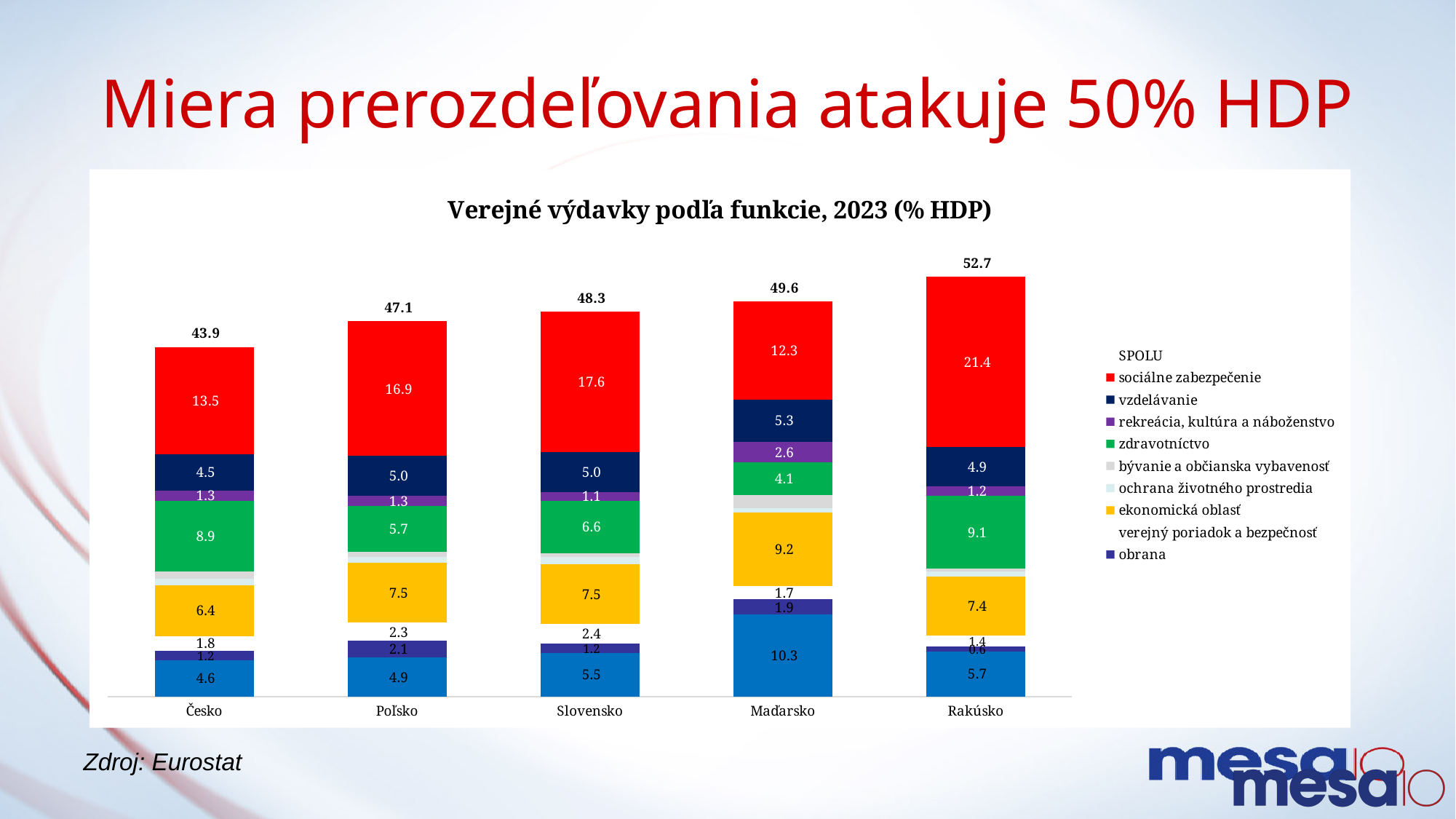
How many countries are shown on the x axis of the chart? 5 What is the difference between the total (SPOLU) values for Rakúsko and Česko? 8.8 What kind of chart is shown on the slide? Stacked bar chart What is the value of 'vzdelávanie' for Maďarsko? 5.3 What is the value of 'sociálne zabezpečenie' for Rakúsko? 21.4 Which country has the larger value for 'ekonomická oblasť', Maďarsko or Poľsko? Maďarsko Which country has the lowest total (SPOLU) public expenditure in the chart? Česko What is the total (SPOLU) value shown above the bar for Slovensko? 48.3 Which country has the highest total (SPOLU) public expenditure in the chart? Rakúsko What is the value of 'zdravotníctvo' for Česko? 8.9 What is the title of the chart? Verejné výdavky podľa funkcie, 2023 (% HDP) Do the total (SPOLU) values rise or fall from left to right across the countries? Rise